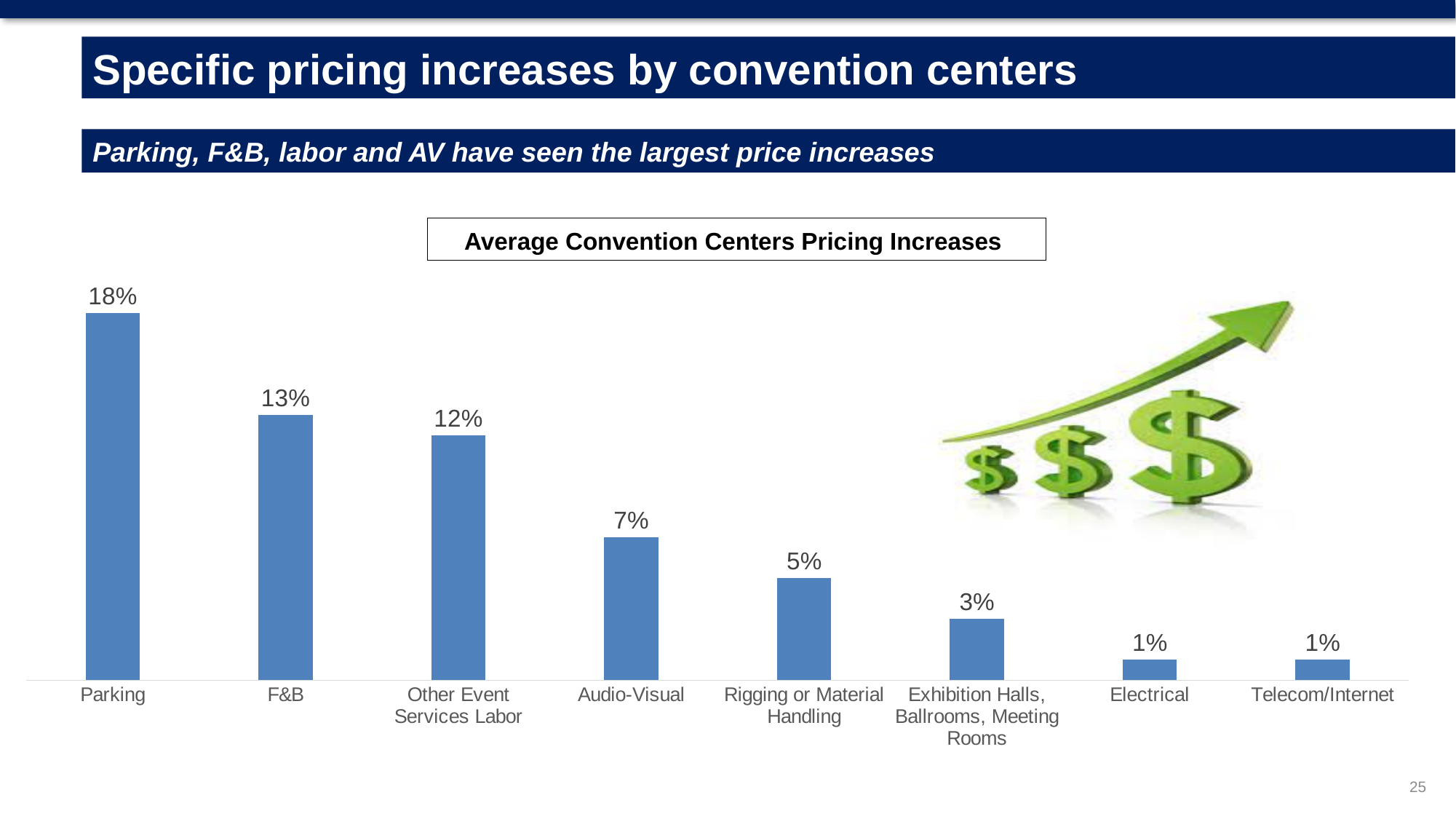
What is the title of the chart? Average Convention Centers Pricing Increases Do the values rise or fall from left to right across the categories? Fall Which has a larger pricing increase, F&B or Audio-Visual? F&B Which has a larger pricing increase, Rigging or Material Handling or Exhibition Halls, Ballrooms, Meeting Rooms? Rigging or Material Handling How many categories are shown in the chart? 8 What is the difference between the pricing increases for Parking and F&B? 5% What is the average pricing increase for Audio-Visual? 7% What is the average pricing increase for Parking? 18% What kind of chart is shown on the slide? Bar chart What is the difference between the pricing increases for Other Event Services Labor and Rigging or Material Handling? 7% What is the average pricing increase for Exhibition Halls, Ballrooms, Meeting Rooms? 3% Which category has the highest average pricing increase? Parking